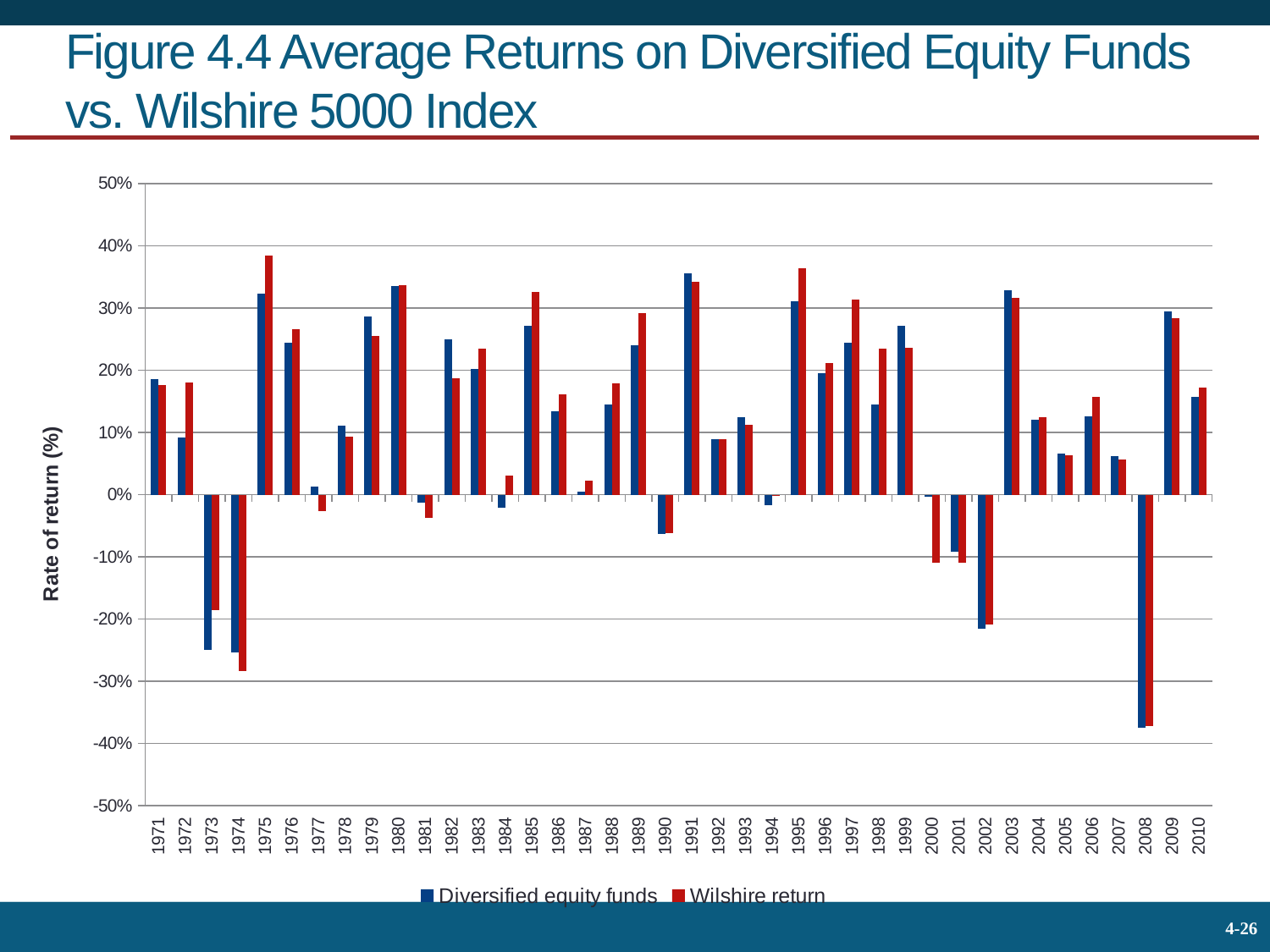
Is the Wilshire return for 1974 greater or less than -20%? less Which year has the lowest Diversified equity funds return? 2008 Which year has the lowest Wilshire return? 2008 How many years are shown along the x axis? 40 In 1997, which is larger: the Diversified equity funds return or the Wilshire return? Wilshire return What is the title of the vertical axis? Rate of return (%) Is the Diversified equity funds return for 2008 greater or less than -30%? less In 1982, which is larger: the Diversified equity funds return or the Wilshire return? Diversified equity funds How many series does the legend list? 2 What kind of chart is shown on the slide? bar chart Is the Wilshire return for 1975 greater or less than 30%? greater